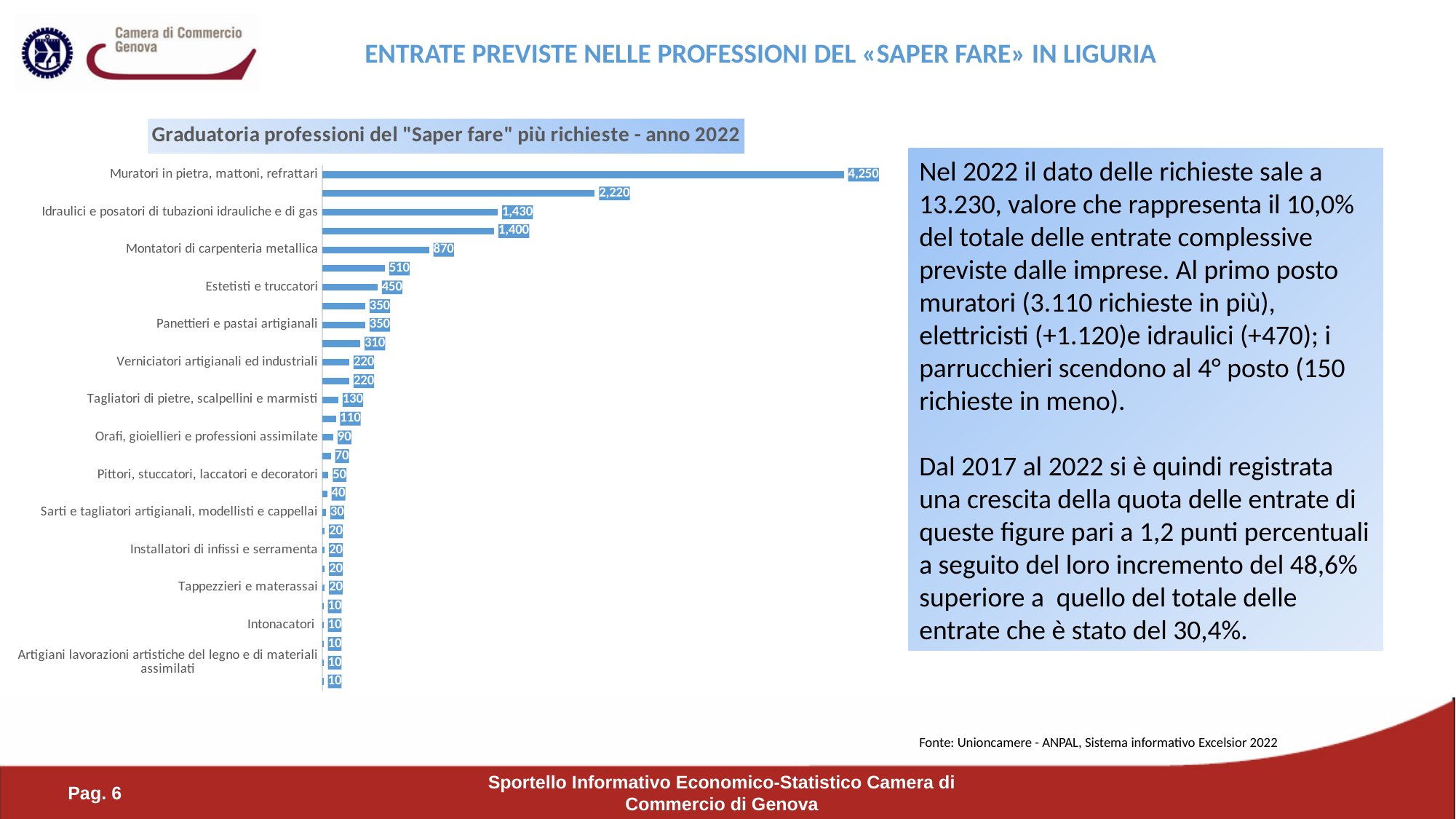
What is the value for Estetisti e truccatori? 450 What is the title of the chart? Graduatoria professioni del "Saper fare" più richieste - anno 2022 What type of chart is shown on the slide? Bar chart What is the value for Idraulici e posatori di tubazioni idrauliche e di gas? 1,430 Which profession has the highest value in the chart? Muratori in pietra, mattoni, refrattari What is the value for Montatori di carpenteria metallica? 870 What is the value for Intonacatori? 10 Which has a larger value: Panettieri e pastai artigianali or Verniciatori artigianali ed industriali? Panettieri e pastai artigianali What is the value for Muratori in pietra, mattoni, refrattari? 4,250 What is the value for Tagliatori di pietre, scalpellini e marmisti? 130 Do the values rise or fall going from the top bar to the bottom bar? Fall What is the difference between the values for Muratori in pietra, mattoni, refrattari and Idraulici e posatori di tubazioni idrauliche e di gas? 2,820